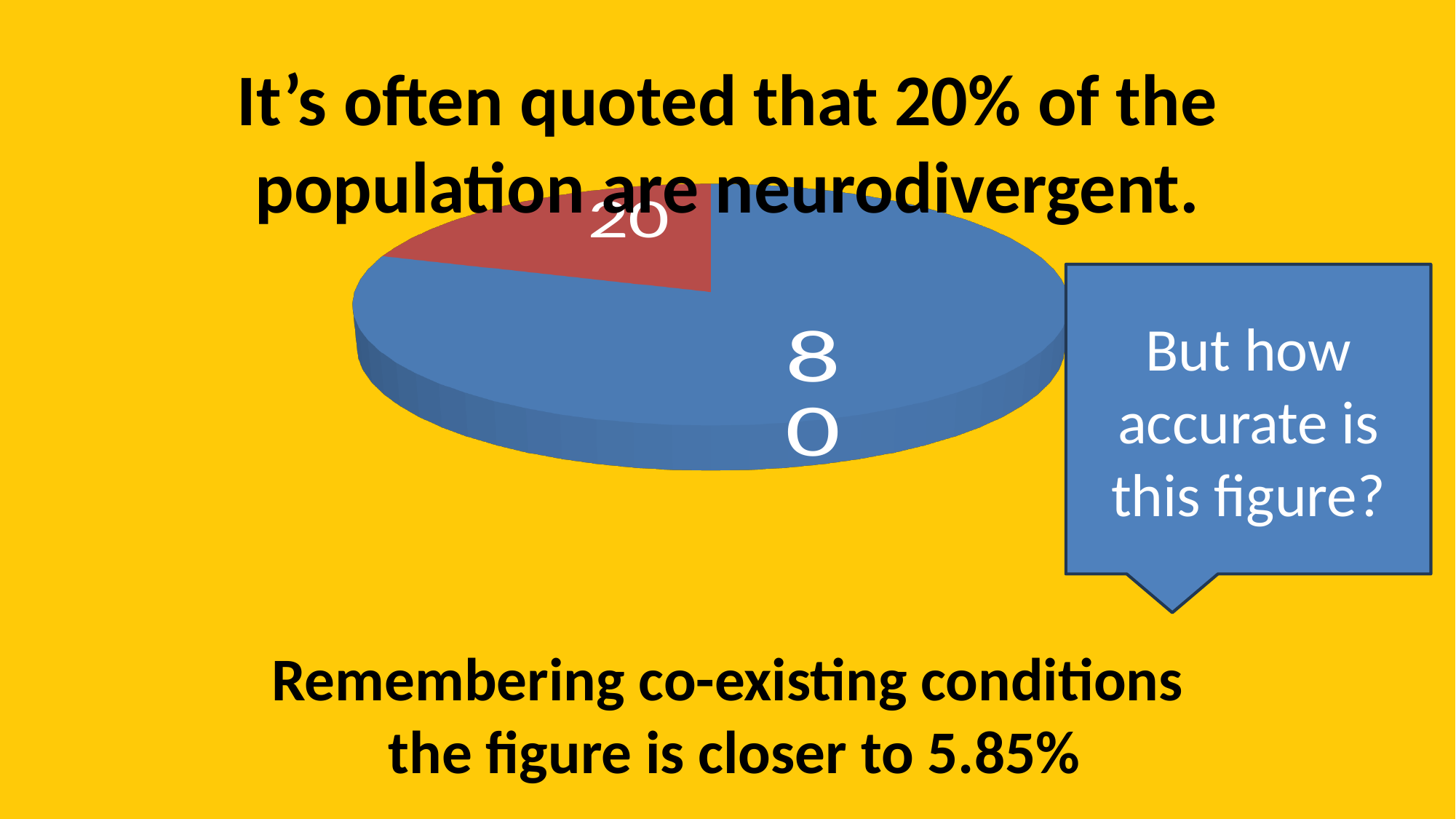
Which slice of the pie chart is the smallest? the red slice (20) Which slice of the pie chart is larger, the red one or the blue one? the blue one What is the difference between the values of the blue slice and the red slice in the pie chart? 60 What kind of chart is shown on the slide? pie chart How many slices does the pie chart have? 2 What value is labelled on the red slice of the pie chart? 20 Does the pie chart have a legend? No What is the total of the two values labelled on the pie chart? 100 Which slice of the pie chart is the largest? the blue slice (80) What colour is the slice labelled 20 in the pie chart? red What value is labelled on the blue slice of the pie chart? 80